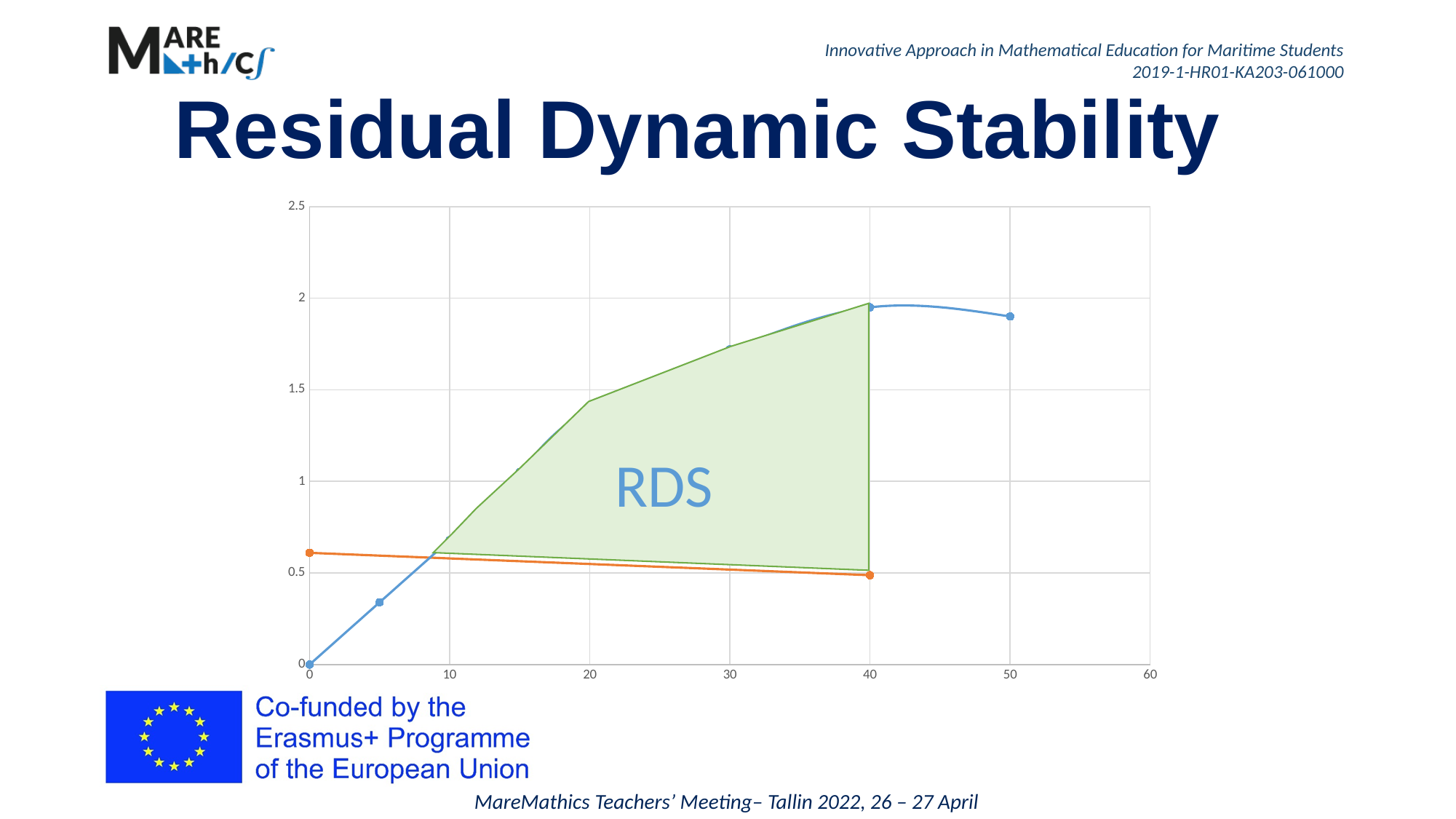
What label is written inside the green shaded area of the chart? RDS At x = 40, which line has the larger value, the blue line or the orange line? blue line Does the blue line rise or fall as x increases from 0 to 40? rise At x = 0, which line has the larger value, the blue line or the orange line? orange line Is the value of the orange line at x = 0 greater or less than 0.5? greater What is the value of the blue line at x = 0? 0 Does the orange line rise or fall as x increases from 0 to 40? fall At which x value does the blue line reach its lowest value? 0 What kind of chart is shown on the slide? line chart Is the value of the blue line at x = 5 greater or less than 0.5? less Is the value of the blue line at x = 50 greater or less than 1.5? greater